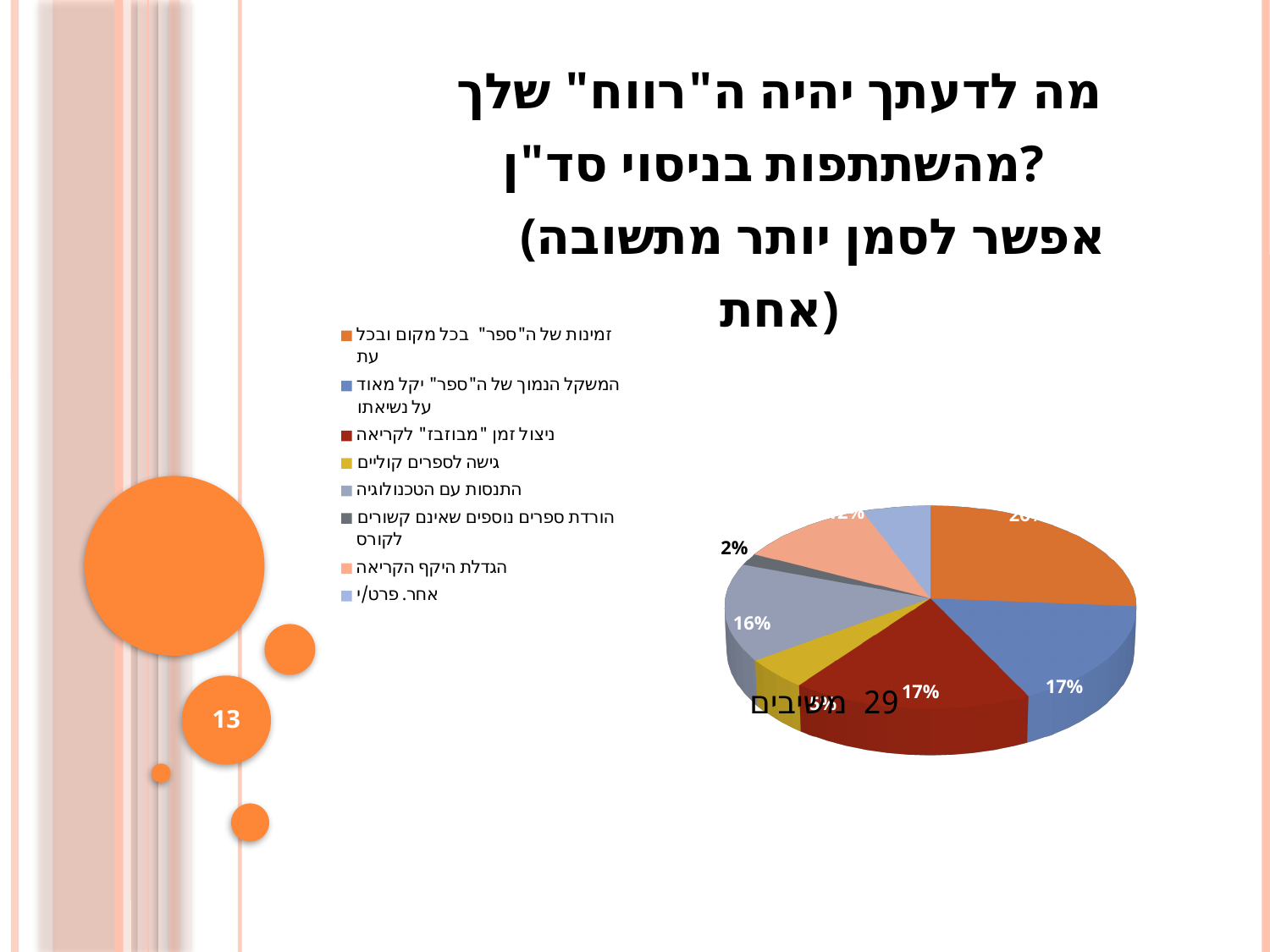
Which category has the smallest slice in the pie chart? הורדת ספרים נוספים שאינם קשורים לקורס Which is larger: the share for "התנסות עם הטכנולוגיה" or the share for "הורדת ספרים נוספים שאינם קשורים לקורס"? התנסות עם הטכנולוגיה What percentage is shown for "הורדת ספרים נוספים שאינם קשורים לקורס"? 2% What percentage is shown for "ניצול זמן "מבוזבז" לקריאה"? 17% What percentage is shown for "התנסות עם הטכנולוגיה"? 16% Which category has the largest slice in the pie chart? זמינות של ה"ספר" בכל מקום ובכל עת What percentage is shown for "המשקל הנמוך של ה"ספר" יקל מאוד על נשיאתו"? 17% What is the difference in percentage points between "התנסות עם הטכנולוגיה" (16%) and "הורדת ספרים נוספים שאינם קשורים לקורס" (2%)? 14 percentage points How many categories does the legend of the pie chart list? 8 What colour is the slice for "גישה לספרים קוליים"? gold/yellow How many respondents (משיבים) does the chart note? 29 What kind of chart is shown on the slide? pie chart